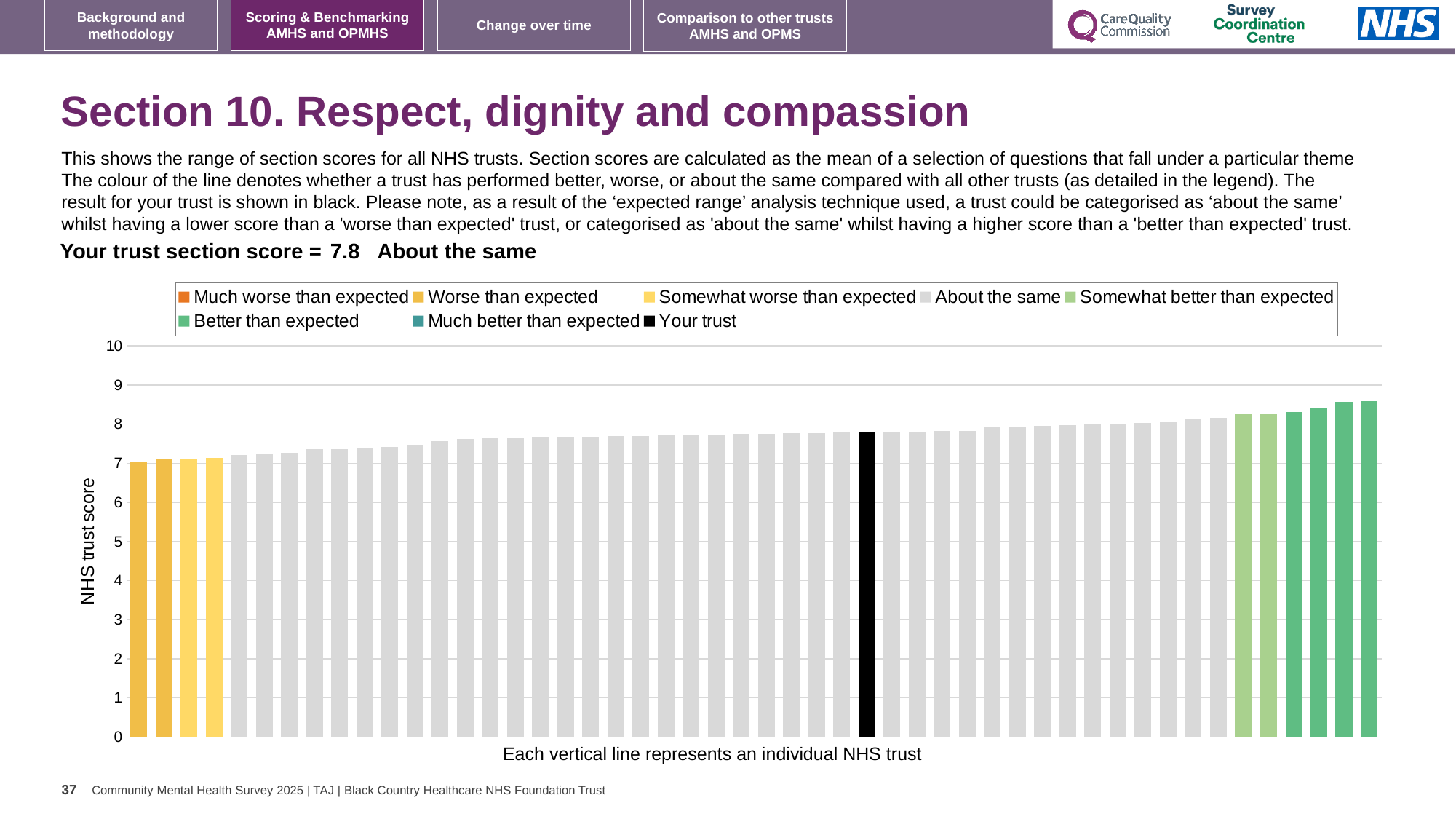
What colour is the bar representing your trust? black Is the value of the tallest bar on the chart greater or less than 8? greater Is the value of the black 'Your trust' bar greater or less than 7? greater What is the section score for your trust shown on the slide? 7.8 Which category is your trust placed in for this section? About the same Is the value of the black 'Your trust' bar greater or less than 8? less Do the bar values rise or fall from left to right across the chart? rise Is the black 'Your trust' bar higher or lower than the leftmost bar on the chart? higher What is the label on the vertical axis of the chart? NHS trust score How many entries does the chart legend list? 8 What kind of chart is shown on the slide? bar chart